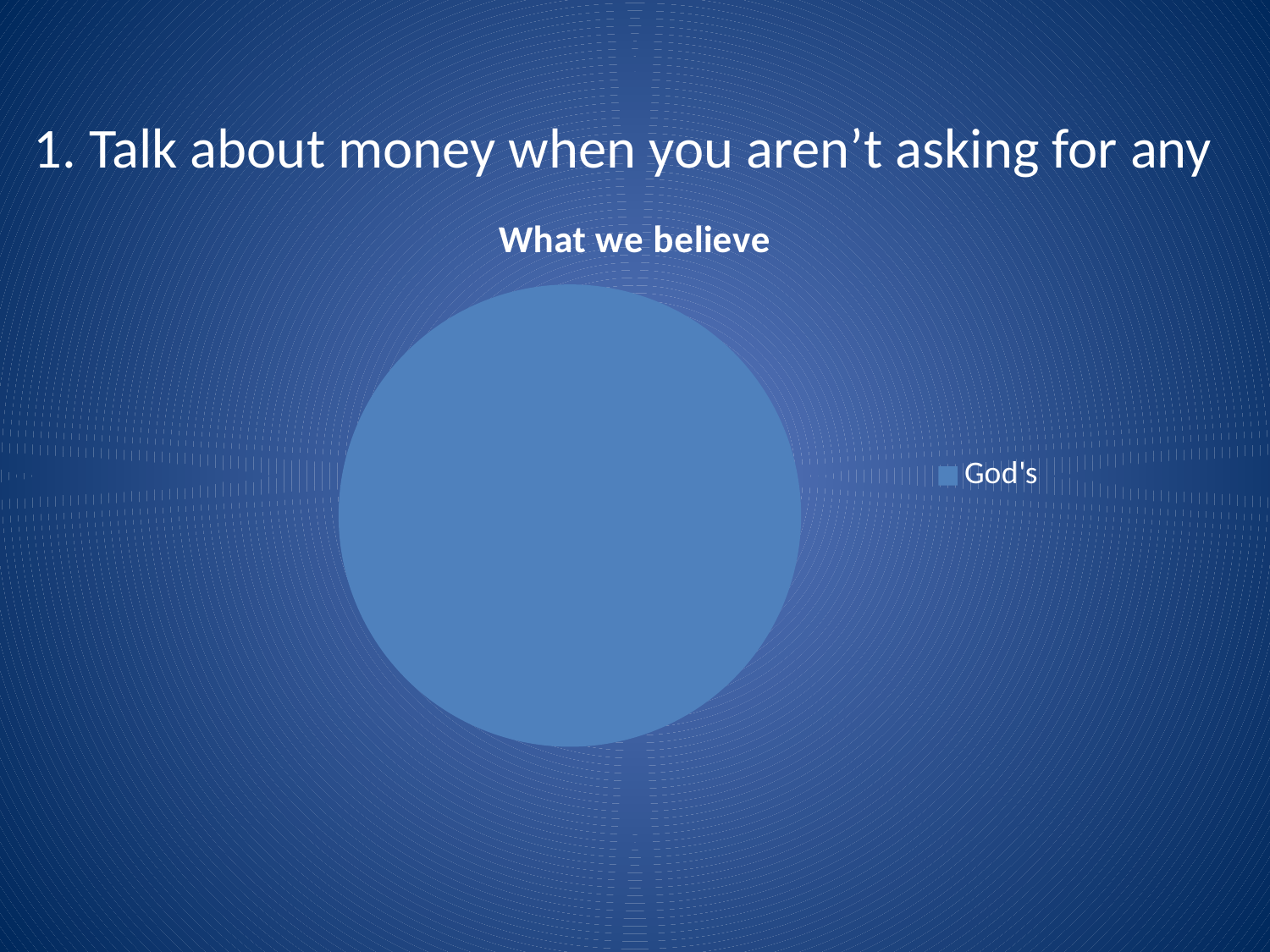
How many slices does the pie chart have? 1 How many entries does the chart's legend list? 1 What is the label of the only slice in the pie chart? God's What share of the pie does the "God's" slice take up? 100% What kind of chart is shown on the slide? pie chart What is the title of the chart? What we believe